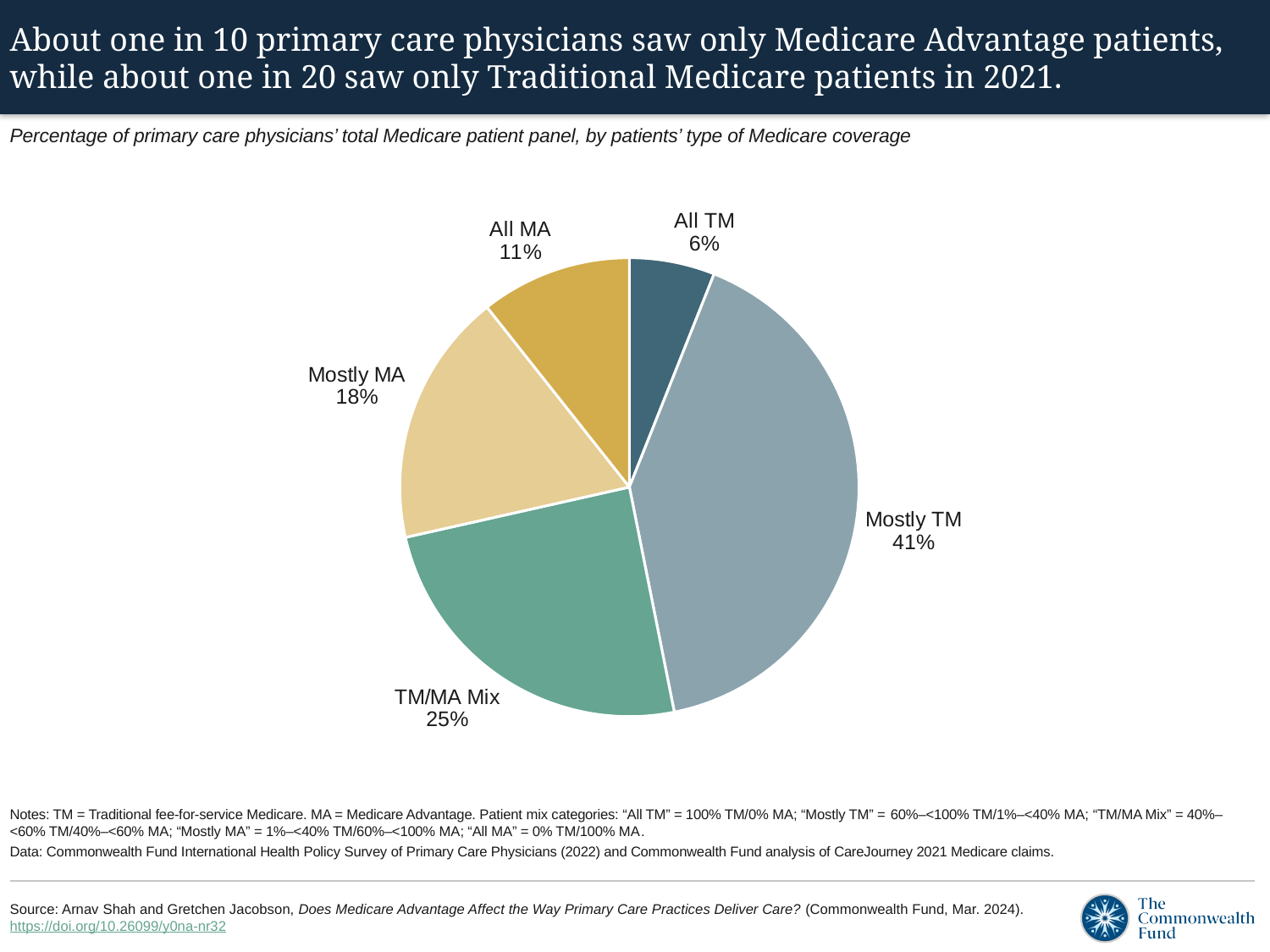
What percentage of the pie is labelled All TM? 6% What percentage of the pie is labelled TM/MA Mix? 25% What percentage of the pie is labelled All MA? 11% How many slices does the pie chart have? 5 What percentage of the pie is labelled Mostly TM? 41% Which category has the largest share of the pie? Mostly TM Which is larger, the share for All MA or the share for All TM? All MA What is the combined share of All MA and Mostly MA? 29% What is the subtitle of the chart? Percentage of primary care physicians' total Medicare patient panel, by patients' type of Medicare coverage What is the difference in percentage points between Mostly TM and Mostly MA? 23 What kind of chart is shown on the slide? Pie chart Which category has the smallest share of the pie? All TM